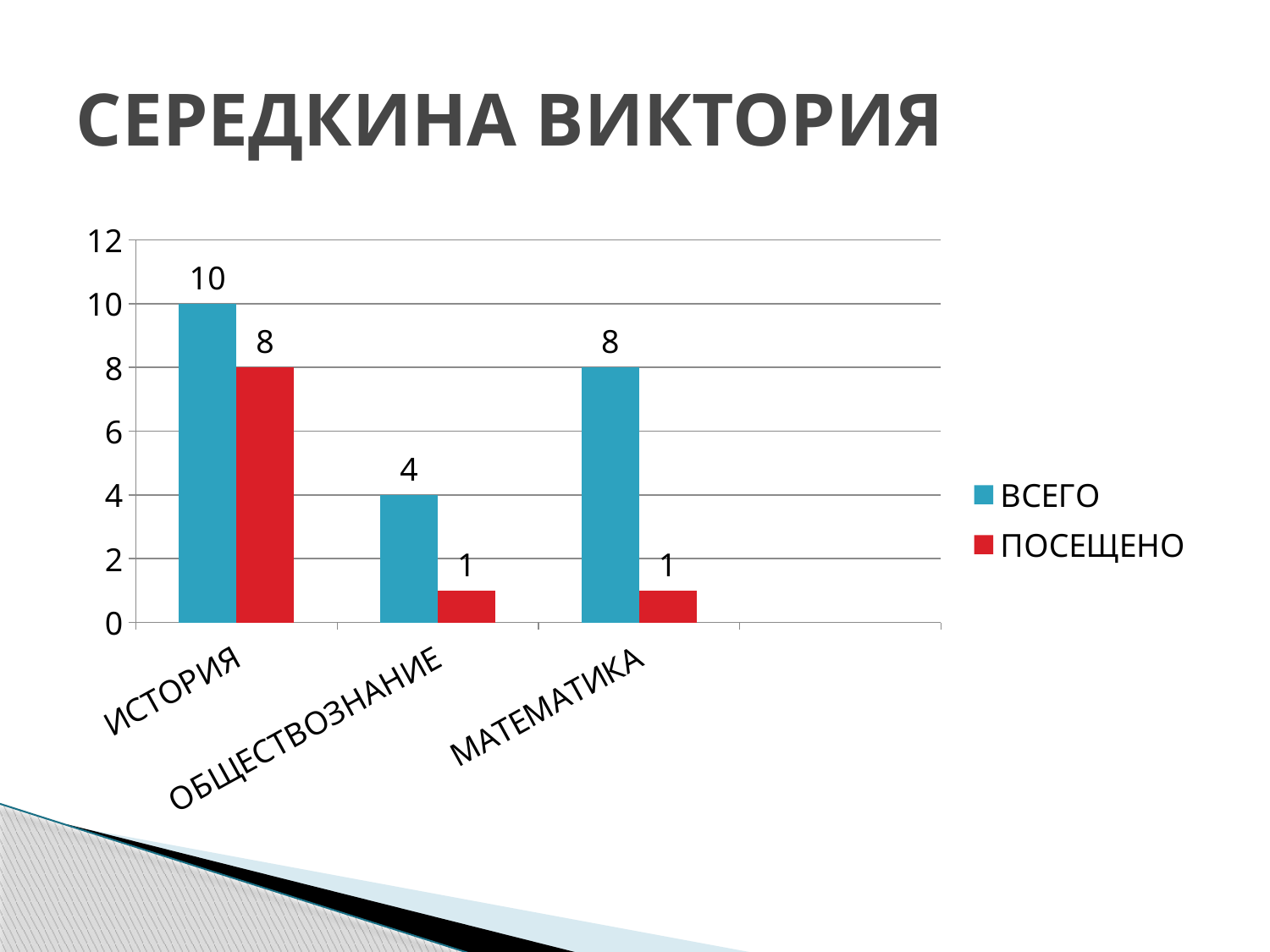
How many series does the legend list? 2 Which category has the lowest ВСЕГО value? ОБЩЕСТВОЗНАНИЕ What kind of chart is shown on the slide? Bar chart What is the difference between the ВСЕГО and ПОСЕЩЕНО values for МАТЕМАТИКА? 7 What is the ВСЕГО value for ОБЩЕСТВОЗНАНИЕ? 4 Which category has the highest ВСЕГО value? ИСТОРИЯ Which series is shown in red? ПОСЕЩЕНО What is the ПОСЕЩЕНО value for ИСТОРИЯ? 8 Which is larger: the ВСЕГО value for ОБЩЕСТВОЗНАНИЕ or the ВСЕГО value for МАТЕМАТИКА? МАТЕМАТИКА What is the ВСЕГО value for ИСТОРИЯ? 10 What is the ПОСЕЩЕНО value for МАТЕМАТИКА? 1 How many categories are shown on the x axis? 3